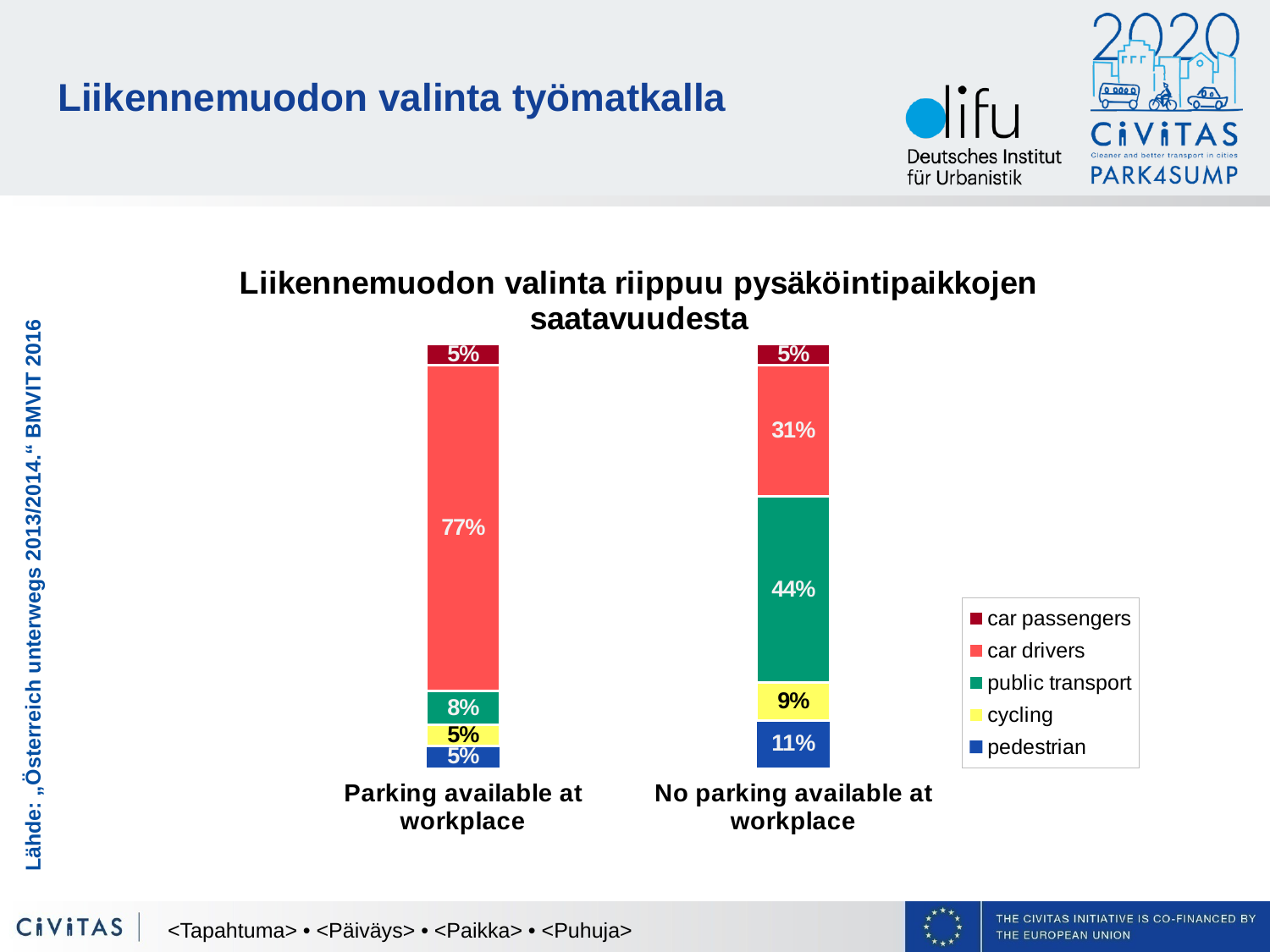
What is the pedestrian share for "No parking available at workplace"? 11% Which series has the largest share in the "No parking available at workplace" bar? public transport Which category has the larger public transport share, "Parking available at workplace" or "No parking available at workplace"? No parking available at workplace What is the total of the "No parking available at workplace" stacked bar? 100% How many categories are shown on the x axis? 2 How many series does the legend list? 5 What kind of chart is shown on the slide? stacked bar chart What share of car drivers is shown for "Parking available at workplace"? 77% What share of public transport is shown for "No parking available at workplace"? 44% Which series has the largest share in the "Parking available at workplace" bar? car drivers What is the difference in the car drivers share between "Parking available at workplace" and "No parking available at workplace"? 46% What is the cycling share for "Parking available at workplace"? 5%